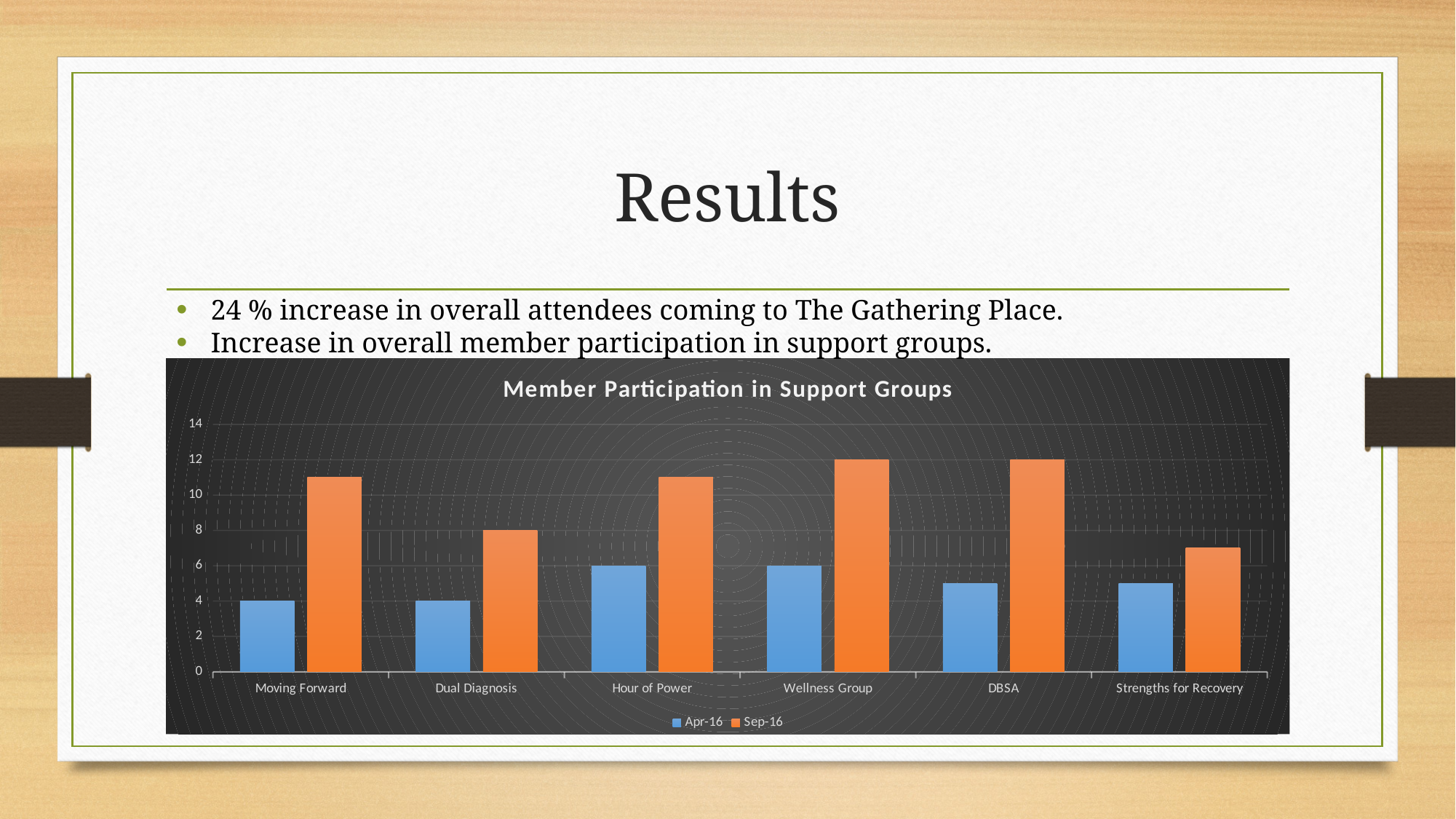
What is the Apr-16 value for Moving Forward? 4 What is the title of the chart? Member Participation in Support Groups How many support groups are shown on the x axis? 6 How many series does the legend list? 2 What is the Sep-16 value for Dual Diagnosis? 8 What is the Sep-16 value for Wellness Group? 12 What is the Apr-16 value for Hour of Power? 6 What type of chart is shown on the slide? Bar chart Is the Sep-16 value for Strengths for Recovery greater or less than 8? less What is the difference between the Sep-16 and Apr-16 values for Wellness Group? 6 Is the Apr-16 value for DBSA greater or less than 4? greater For Moving Forward, which is larger: the Apr-16 value or the Sep-16 value? Sep-16